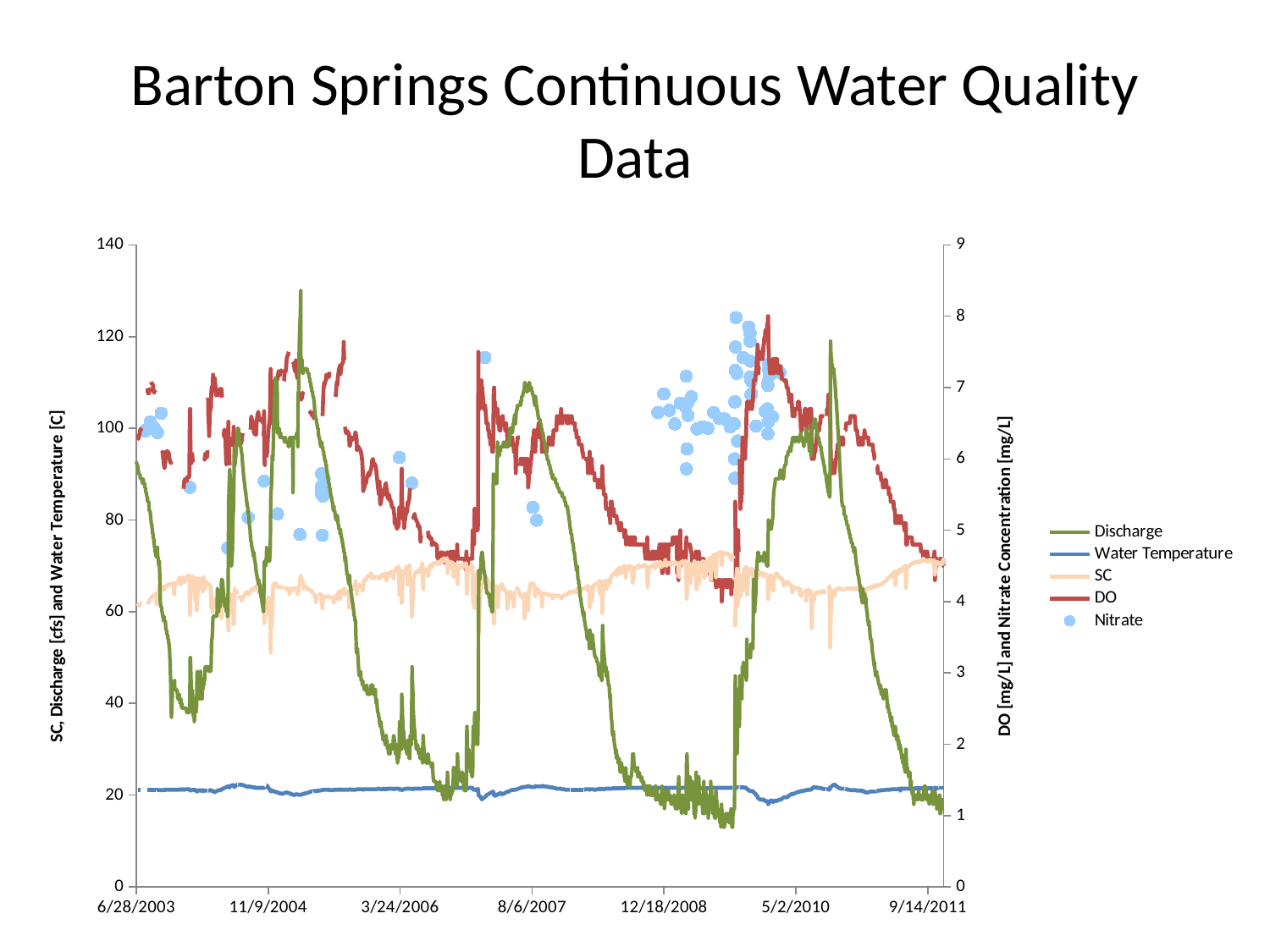
Is the SC value greater or less than 40 throughout the chart? greater What kind of chart is shown on the slide? line chart Which series is plotted as dots rather than a line? Nitrate What is the title of the chart? Barton Springs Continuous Water Quality Data What is the maximum value shown on the right vertical axis? 9 What is the maximum value shown on the left vertical axis? 140 Which series is consistently higher on the left axis, SC or Water Temperature? SC How many series does the legend list? 5 Is the highest Discharge value greater or less than 120? greater Does the Water Temperature series rise, fall, or stay roughly flat across the x axis? roughly flat What is the first date shown on the x axis? 6/28/2003 Is the Water Temperature value greater or less than 40 throughout the chart? less